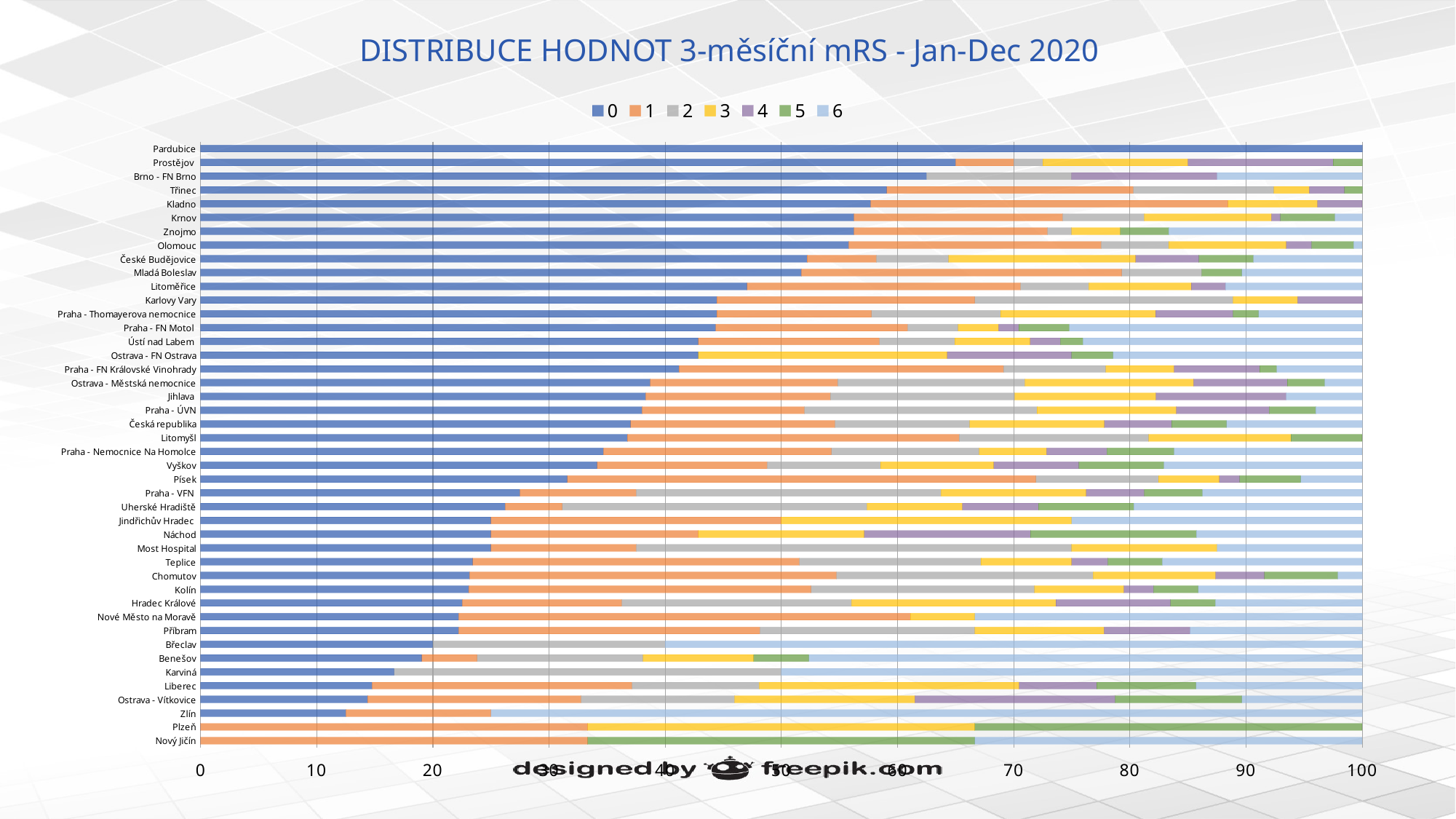
Which has the larger value for series 0, Brno - FN Brno or Liberec? Brno - FN Brno What is the maximum value shown on the horizontal axis? 100 Is the value for series 0 for Pardubice greater or less than 90? greater What is the title of the chart? DISTRIBUCE HODNOT 3-měsíční mRS - Jan-Dec 2020 Which has the larger value for series 0, Třinec or Benešov? Třinec Which category has the largest value for series 0? Pardubice Is the value for series 0 for Zlín greater or less than 20? less Is the value for series 0 for Karviná greater or less than 30? less How many categories (hospitals/regions) are plotted on the chart? 44 What kind of chart is shown on the slide? Stacked bar chart How many series does the legend list? 7